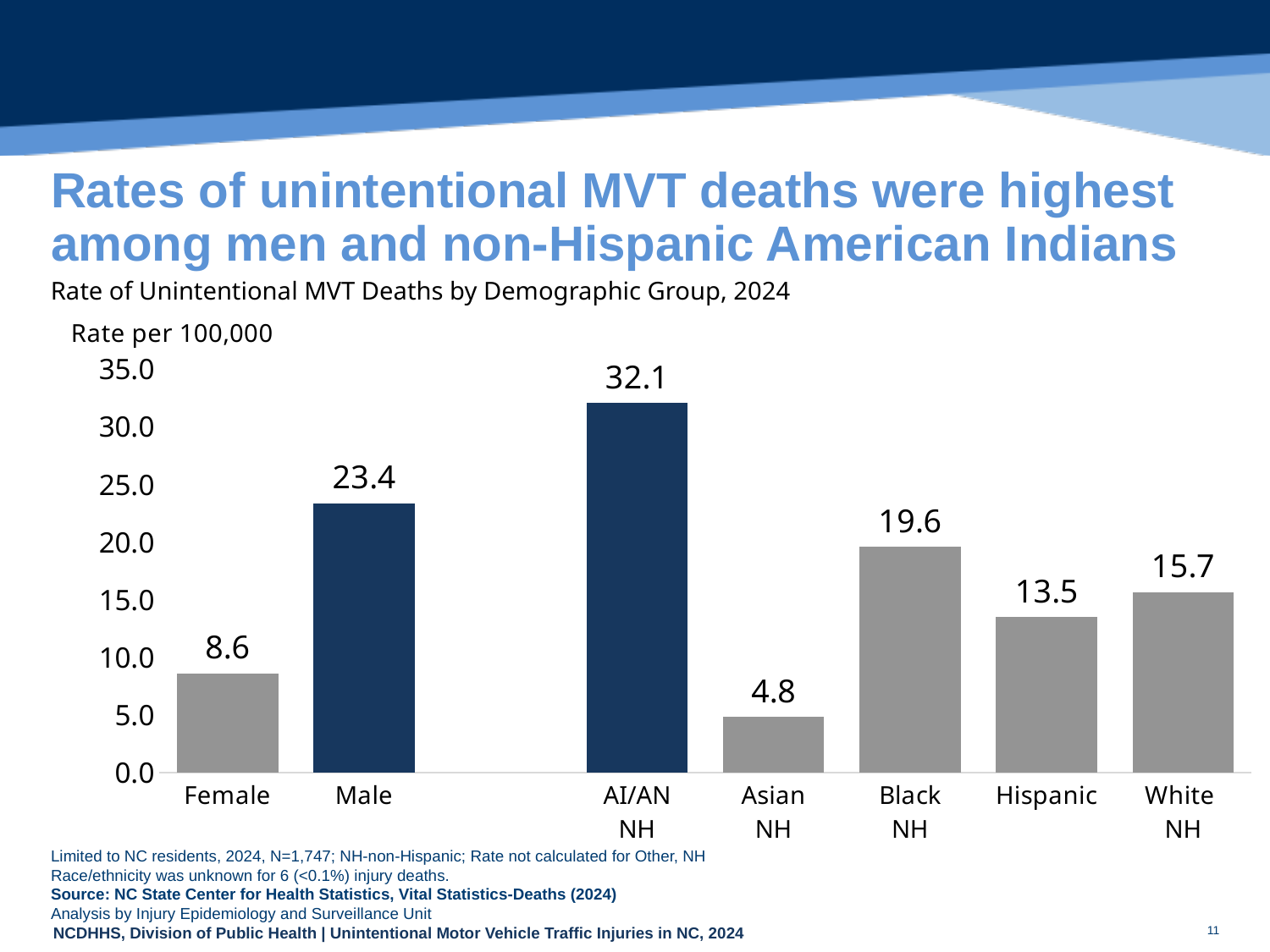
What type of chart is used to show the rate of unintentional MVT deaths by demographic group? Bar chart What unit is the y-axis of the chart labeled with? Rate per 100,000 Which demographic group has the highest rate of unintentional MVT deaths? AI/AN NH Which demographic group has the lowest rate of unintentional MVT deaths? Asian NH How many demographic groups are shown in the chart? 7 What is the rate of unintentional MVT deaths per 100,000 for Asian NH? 4.8 What is the rate of unintentional MVT deaths per 100,000 for Hispanic? 13.5 What is the difference between the Black NH and White NH rates of unintentional MVT deaths? 3.9 Which has a higher rate of unintentional MVT deaths, Hispanic or White NH? White NH What is the rate of unintentional MVT deaths per 100,000 for Male? 23.4 What is the difference between the Male and Female rates of unintentional MVT deaths? 14.8 Is the rate for AI/AN NH greater or less than 30.0? greater